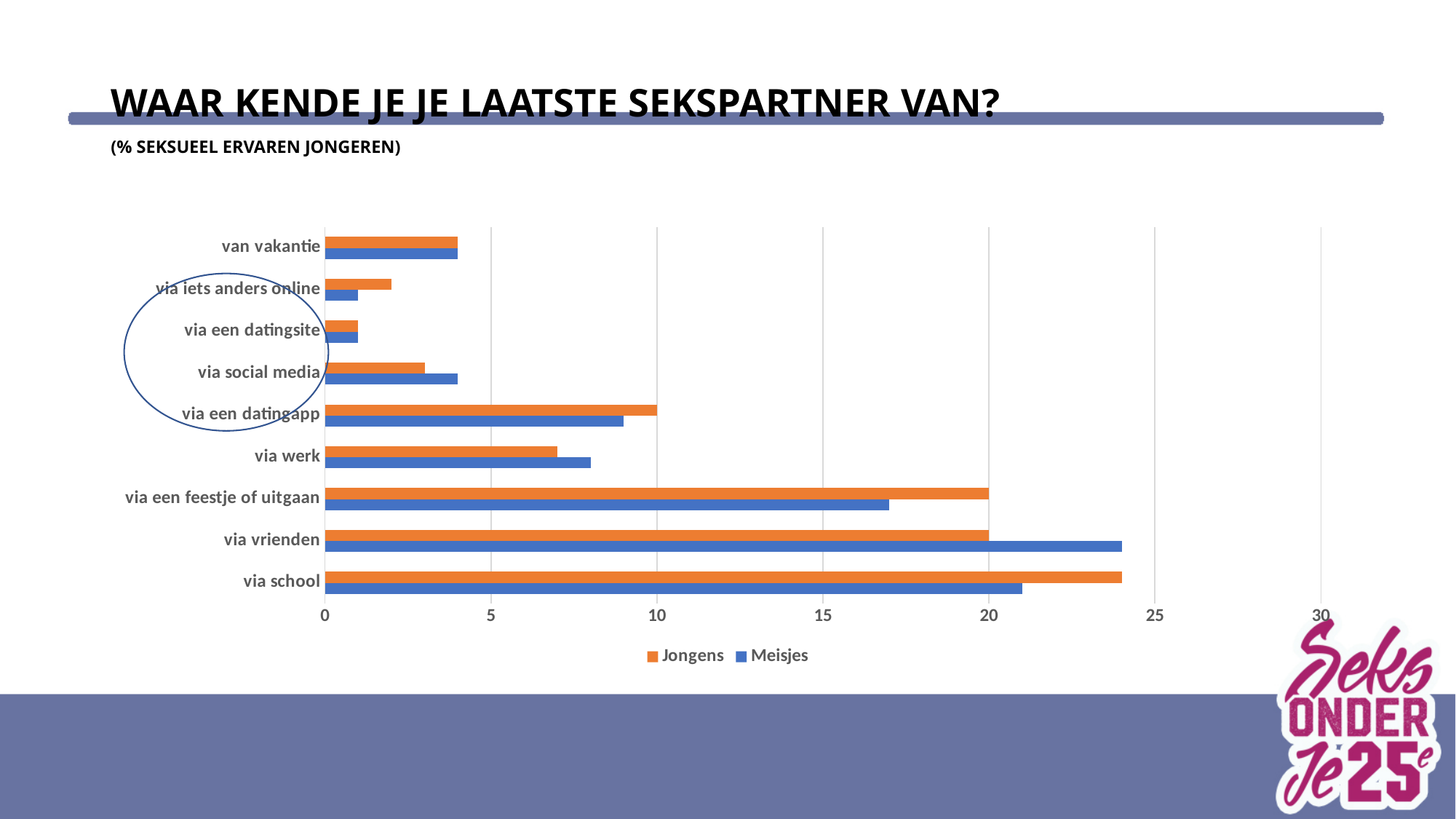
What is the value for Jongens for 'via een feestje of uitgaan'? 20 Is the value for Meisjes for 'via werk' greater or less than 5? greater For 'via vrienden', which series has the larger value, Jongens or Meisjes? Meisjes How many series does the legend list? 2 Which colour represents the Jongens series in the legend? orange For 'via school', which series has the larger value, Jongens or Meisjes? Jongens How many categories are shown on the chart? 9 Which category has the highest value for Jongens? via school Is the value for Jongens for 'van vakantie' greater or less than 5? less Which category has the highest value for Meisjes? via vrienden What is the value for Jongens for 'via een datingapp'? 10 What kind of chart is shown on the slide? bar chart